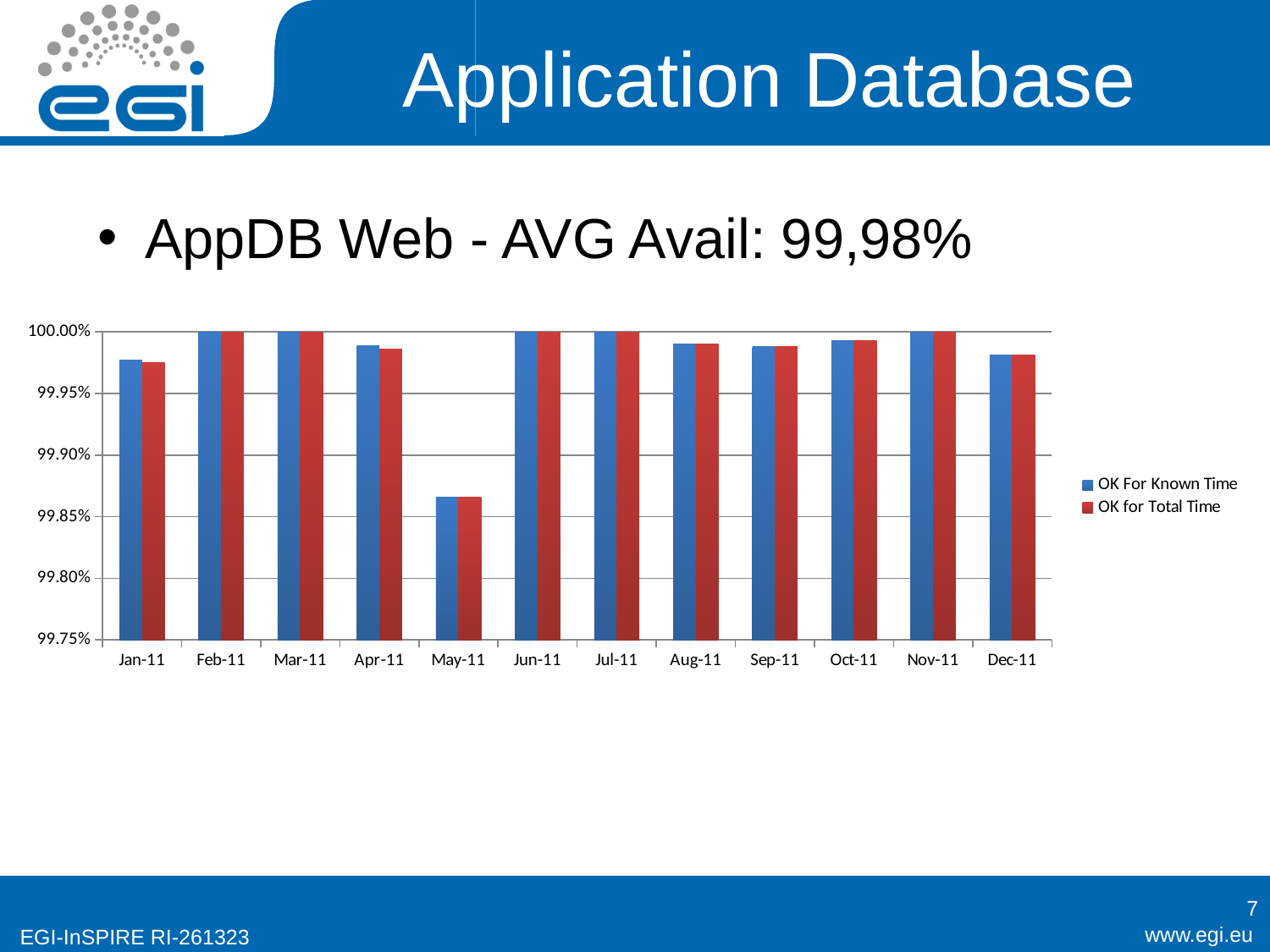
Is the OK for Total Time value for Dec-11 greater or less than 99.95%? greater Which month has the lowest availability in the chart? May-11 Is the OK For Known Time value for May-11 greater or less than 99.90%? less Which is larger, the OK For Known Time value for May-11 or for Jun-11? Jun-11 How many months are shown on the x axis of the chart? 12 Is the OK For Known Time value for Jan-11 greater or less than 99.95%? greater What are the two series named in the chart legend? OK For Known Time and OK for Total Time What is the OK For Known Time value for Feb-11? 100.00% What colour are the OK for Total Time bars in the chart? red How many series does the chart legend list? 2 What kind of chart is shown on the slide? bar chart What is the OK for Total Time value for Nov-11? 100.00%